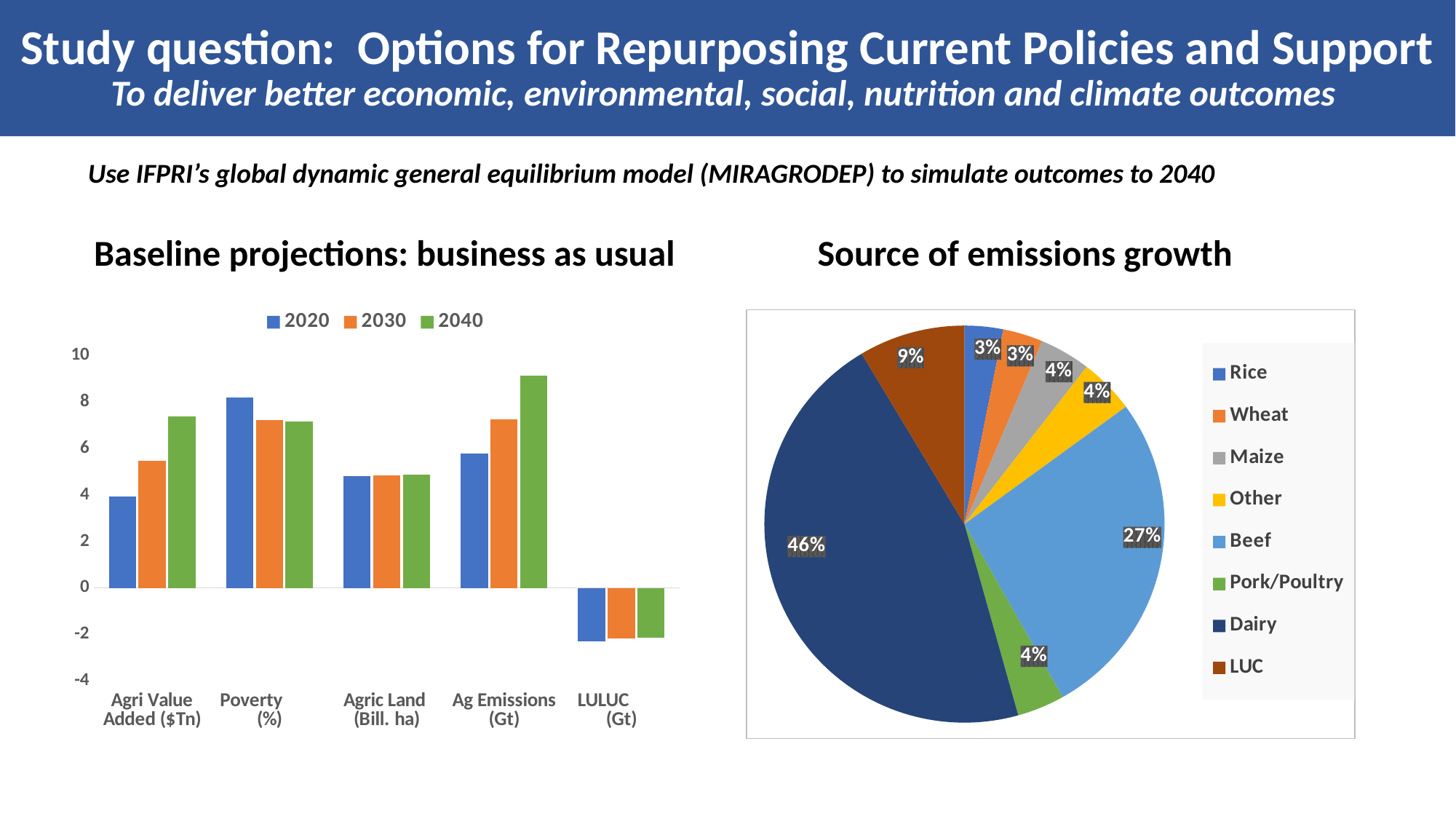
How many series does the legend of the 'Baseline projections: business as usual' chart list? 3 In the 'Baseline projections: business as usual' chart, is the 2020 value for LULUC (Gt) greater or less than 0? less In the 'Source of emissions growth' pie chart, which source has the largest share? Dairy In the 'Source of emissions growth' pie chart, how many percentage points larger is Dairy's share than Beef's? 19 percentage points How many slices does the 'Source of emissions growth' pie chart have? 8 In the 'Baseline projections: business as usual' chart, do the Ag Emissions (Gt) values rise or fall from 2020 to 2040? rise In the 'Baseline projections: business as usual' chart, which is larger for Agri Value Added ($Tn): the 2020 value or the 2040 value? 2040 In the 'Source of emissions growth' pie chart, what share does LUC account for? 9% In the 'Source of emissions growth' pie chart, what share does Beef account for? 27% In the 'Baseline projections: business as usual' chart, is the 2040 value for Ag Emissions (Gt) greater or less than 8? greater In the 'Source of emissions growth' pie chart, what share does Dairy account for? 46% What type of chart is 'Baseline projections: business as usual'? Bar chart